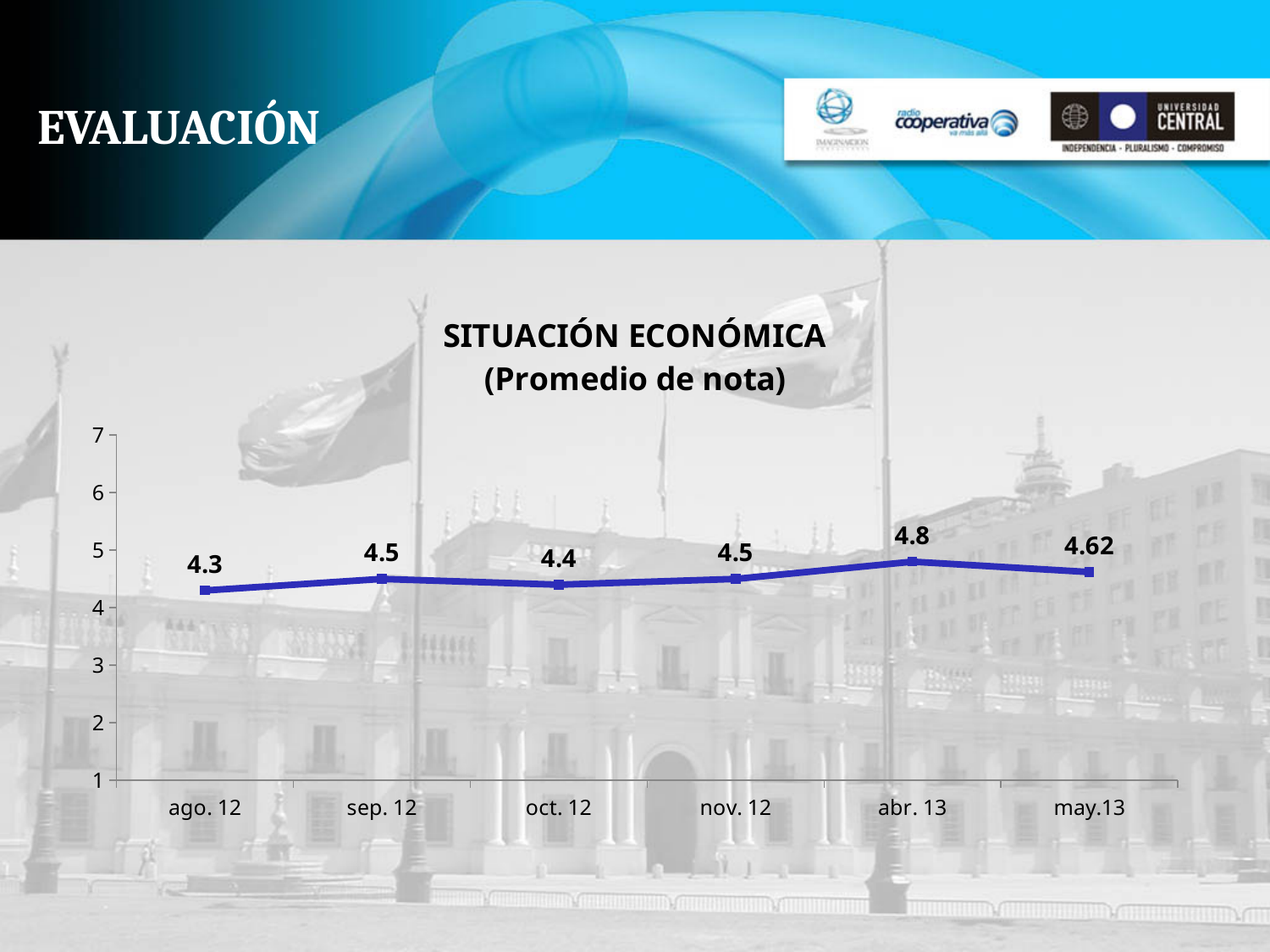
What is the difference between the values for abr. 13 and ago. 12? 0.5 Which is larger, the value for abr. 13 or the value for may.13? abr. 13 Which period has the lowest value? ago. 12 Which period has the highest value? abr. 13 How many periods are plotted on the x axis? 6 What is the title of the chart? SITUACIÓN ECONÓMICA (Promedio de nota) What is the value for ago. 12? 4.3 What is the value for oct. 12? 4.4 What is the value for abr. 13? 4.8 Is the value for nov. 12 greater or less than 5? less What is the value for may.13? 4.62 What kind of chart is shown? line chart